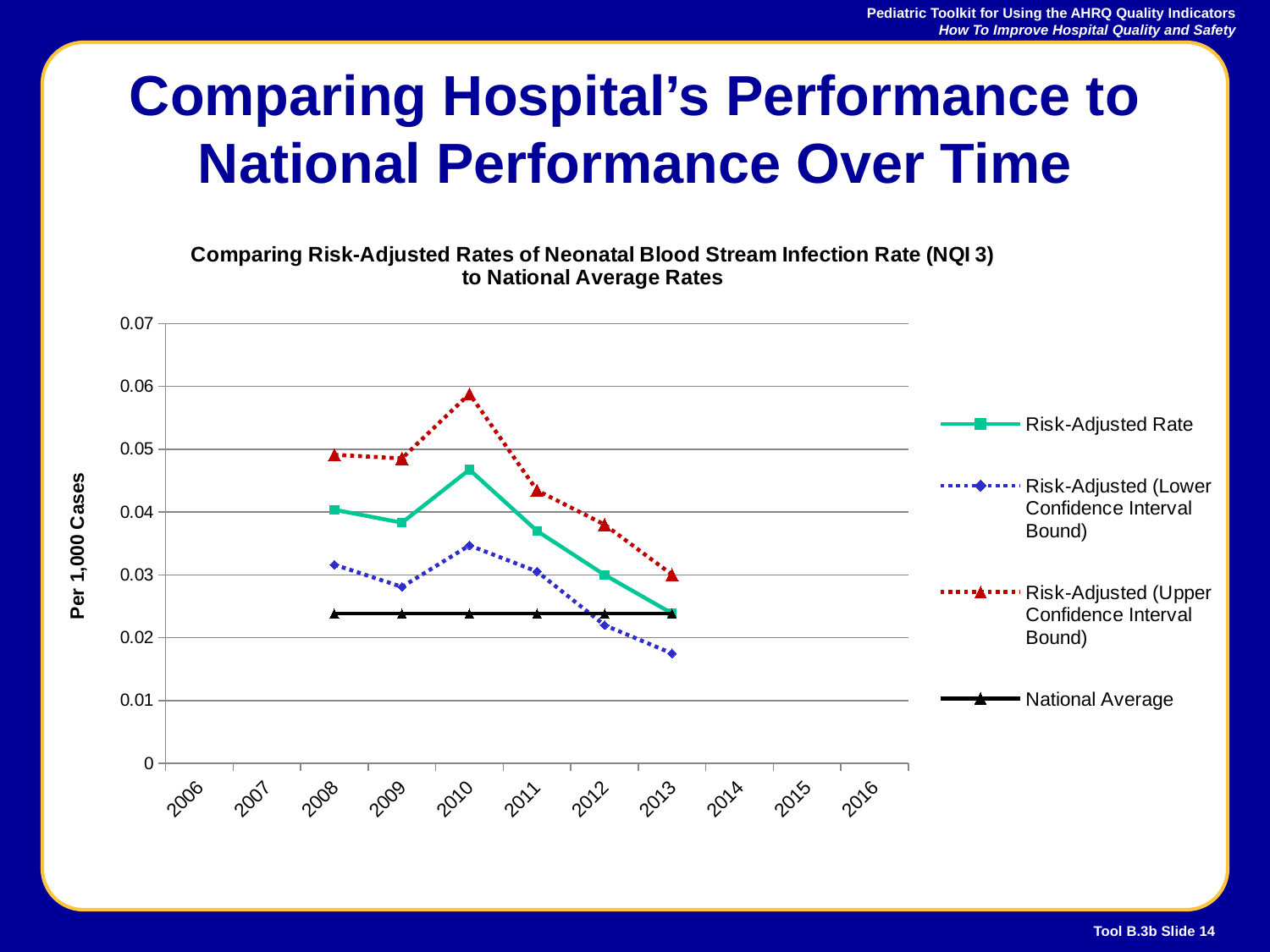
Is the Risk-Adjusted Rate in 2010 greater or less than 0.04? greater Is the Risk-Adjusted Rate in 2011 greater or less than 0.04? less Does the Risk-Adjusted Rate rise or fall from 2010 to 2013? Fall How many series does the legend list? 4 What kind of chart is shown on the slide? Line chart What is the label on the y axis? Per 1,000 Cases In which year is the Risk-Adjusted Rate highest? 2010 Is the Risk-Adjusted (Upper Confidence Interval Bound) in 2010 greater or less than 0.05? greater Which is larger, the Risk-Adjusted Rate in 2009 or in 2010? 2010 In which year is the Risk-Adjusted (Lower Confidence Interval Bound) lowest? 2013 How many years are labelled on the x axis? 11